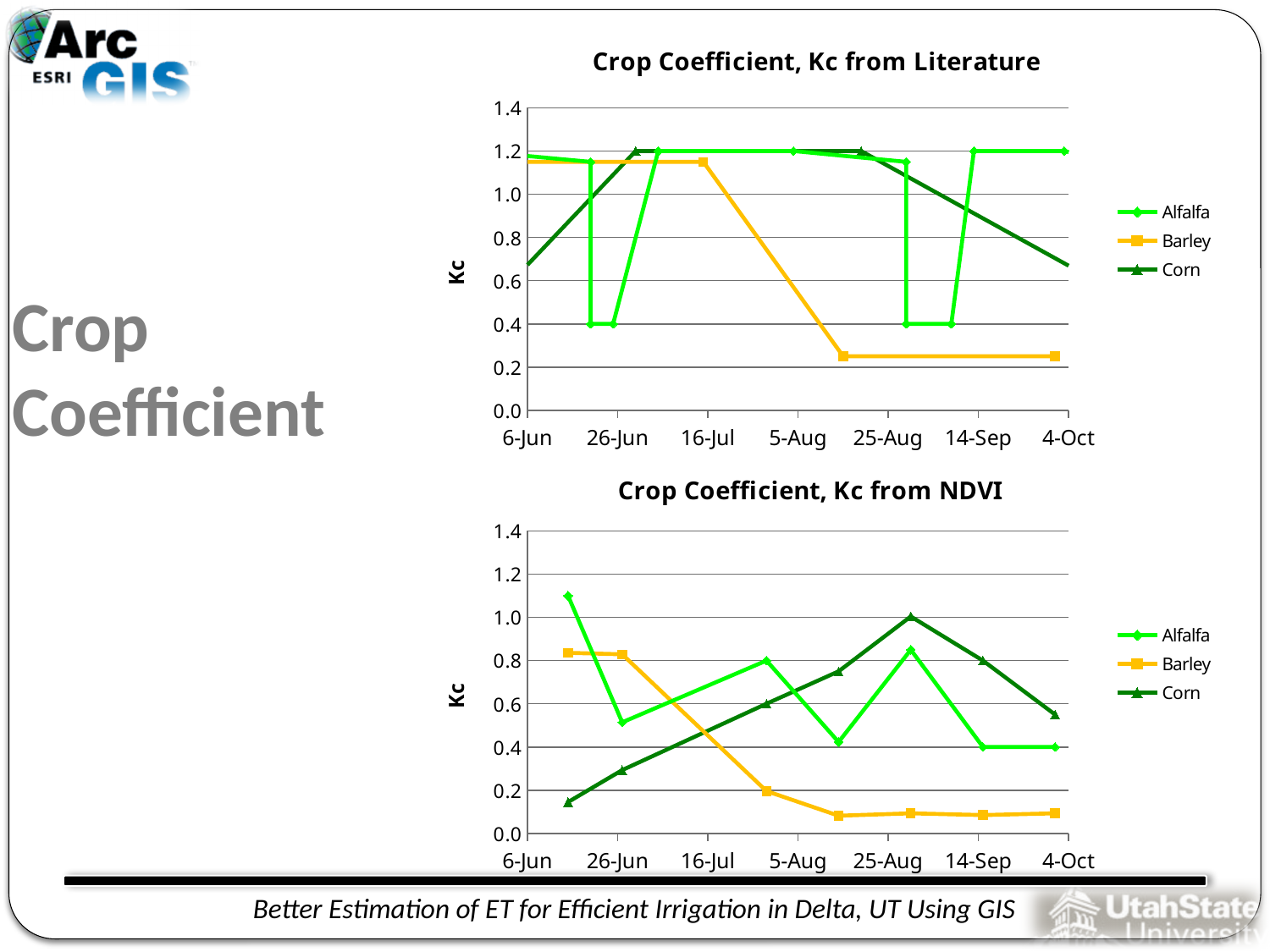
In the 'Crop Coefficient, Kc from Literature' chart, is the Corn value at 4-Oct greater or less than 0.6? greater In the 'Crop Coefficient, Kc from Literature' chart, does the Corn line rise or fall between 25-Aug and 4-Oct? fall In the 'Crop Coefficient, Kc from NDVI' chart, do the Barley values overall rise or fall from 6-Jun to 4-Oct? fall What is the y-axis label on the 'Crop Coefficient, Kc from NDVI' chart? Kc In the 'Crop Coefficient, Kc from Literature' chart, is the Barley value at 4-Oct greater or less than 0.4? less Which series are listed in the legend of the 'Crop Coefficient, Kc from Literature' chart? Alfalfa, Barley, Corn In the 'Crop Coefficient, Kc from NDVI' chart, which is higher at 4-Oct, Corn or Alfalfa? Corn In the 'Crop Coefficient, Kc from NDVI' chart, which series reaches the highest value on the chart? Alfalfa In the 'Crop Coefficient, Kc from NDVI' chart, is the highest Corn value greater or less than 0.8? greater What kind of chart is the 'Crop Coefficient, Kc from Literature' chart? line chart How many series does the legend of the 'Crop Coefficient, Kc from NDVI' chart list? 3